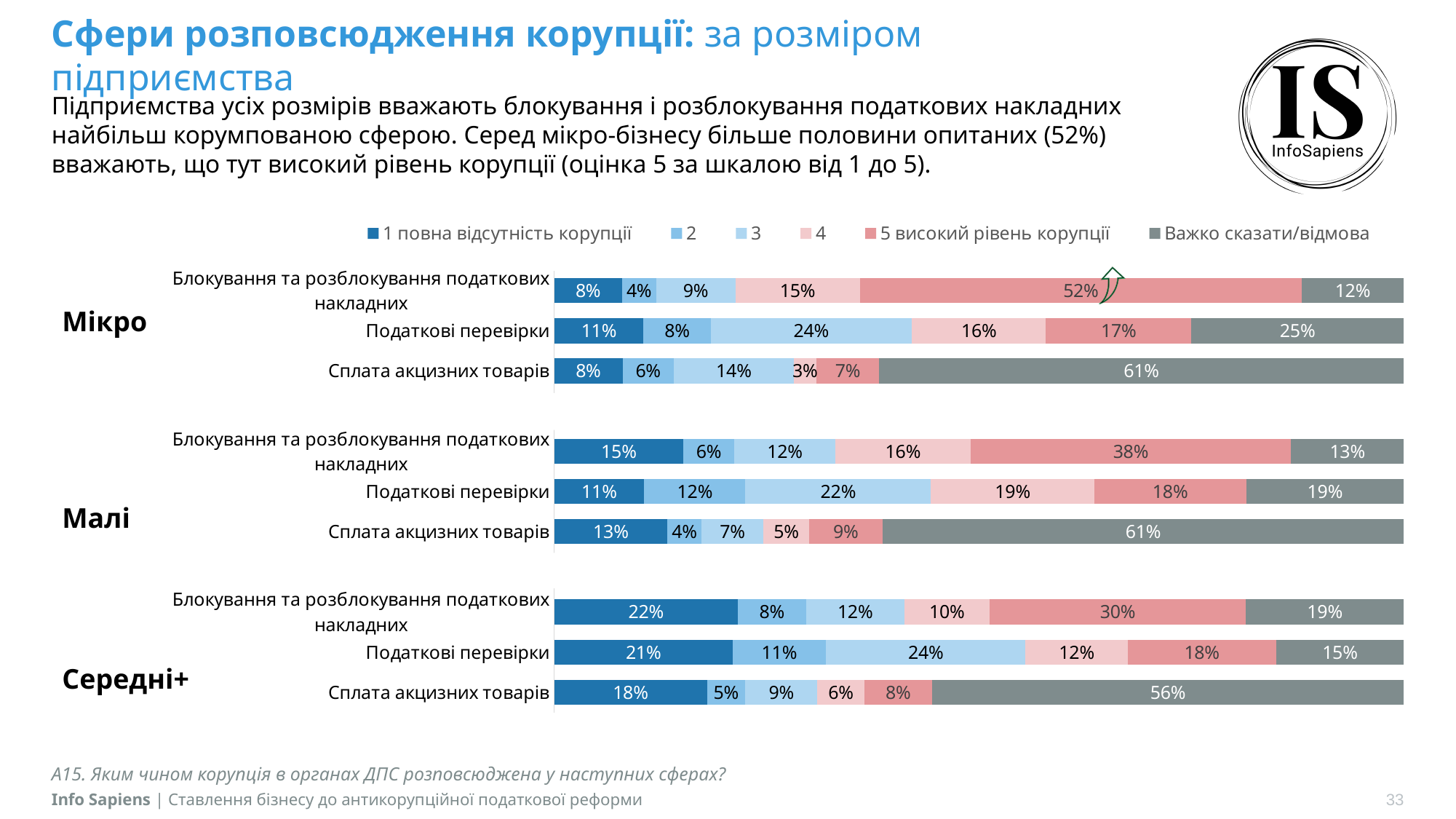
How many series does the legend list? 6 What type of chart is shown on the slide? Stacked bar chart What is the value of "5 високий рівень корупції" for "Блокування та розблокування податкових накладних" in the Мікро group? 52% Which series in the Середні+ group for "Сплата акцизних товарів" has the lowest value? 2 Which is larger: the "Важко сказати/відмова" value for "Податкові перевірки" in the Мікро group or in the Середні+ group? Мікро How many bars (category rows) are plotted in the chart in total? 9 What is the difference between the "5 високий рівень корупції" values for "Блокування та розблокування податкових накладних" in the Мікро and Середні+ groups? 22 percentage points What is the value of "1 повна відсутність корупції" for "Податкові перевірки" in the Середні+ group? 21% What is the value of "3" for "Податкові перевірки" in the Мікро group? 24% What is the value of "4" for "Податкові перевірки" in the Малі group? 19% Across the three groups, which group has the highest "5 високий рівень корупції" value for "Блокування та розблокування податкових накладних"? Мікро What is the value of "Важко сказати/відмова" for "Сплата акцизних товарів" in the Малі group? 61%